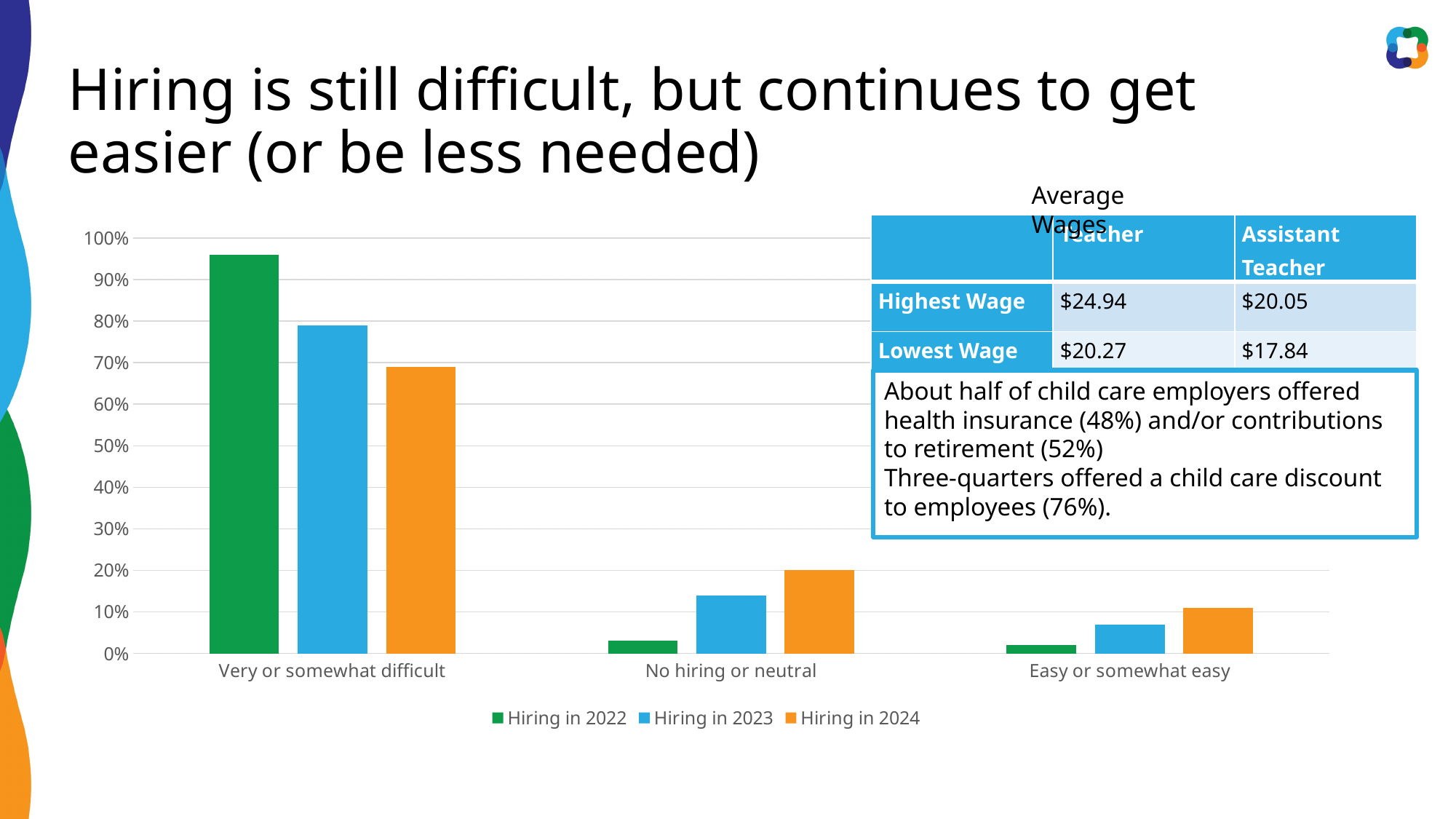
Is the value for Hiring in 2024 in the 'Easy or somewhat easy' category greater or less than 20%? less Across the three years, does the value for 'Very or somewhat difficult' rise or fall from 2022 to 2024? fall What kind of chart is shown on the slide? bar chart Is the value for Hiring in 2023 in the 'Very or somewhat difficult' category greater or less than 70%? greater Is the value for Hiring in 2022 in the 'Easy or somewhat easy' category greater or less than 10%? less In the 'No hiring or neutral' category, which is larger: Hiring in 2023 or Hiring in 2024? Hiring in 2024 How many categories are shown on the x axis of the chart? 3 How many series does the chart legend list? 3 Which series has the highest value in the 'Very or somewhat difficult' category? Hiring in 2022 Which series has the lowest value in the 'No hiring or neutral' category? Hiring in 2022